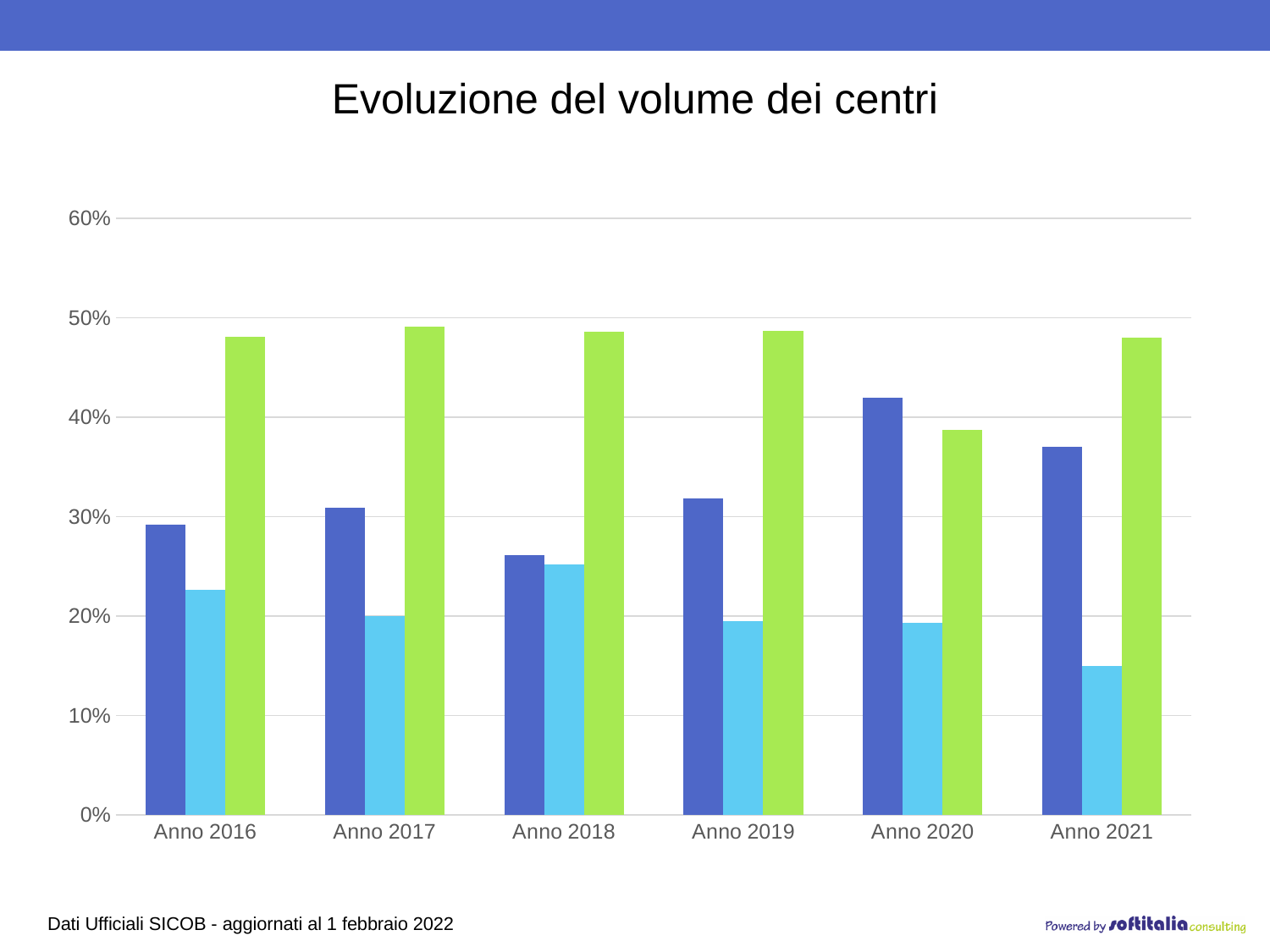
Is the value of the light blue bar for Anno 2018 greater or less than 20%? greater How many bars are plotted for each year category? 3 How many year categories are shown on the x axis? 6 For Anno 2016, which bar is taller: the green bar or the dark blue bar? the green bar Is the value of the dark blue bar for Anno 2020 greater or less than 40%? greater Is the value of the light blue bar for Anno 2021 greater or less than 20%? less What is the title of the chart? Evoluzione del volume dei centri For Anno 2020, which bar is taller: the dark blue bar or the green bar? the dark blue bar In which year is the light blue bar the lowest? Anno 2021 What kind of chart is shown on the slide? bar chart In which year is the dark blue bar the highest? Anno 2020